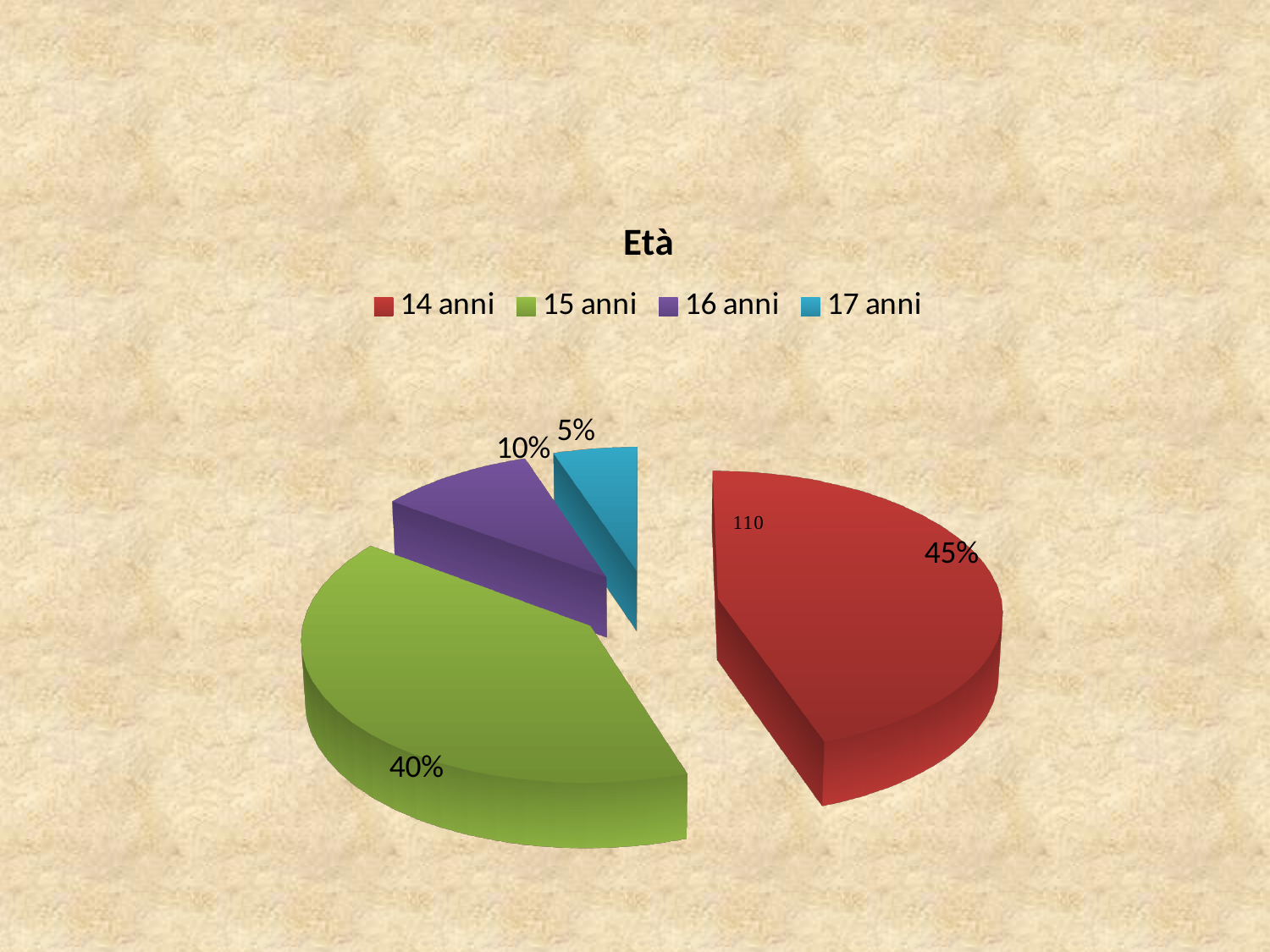
How many categories does the legend list? 4 What percentage of the pie is the 16 anni slice? 10% What is the title of the chart? Età What is the difference in percentage points between the 14 anni and 15 anni slices? 5% What kind of chart is shown on the slide? pie chart What colour is the 15 anni slice? green What percentage of the pie is the 14 anni slice? 45% Which age group has the largest share of the pie? 14 anni What percentage of the pie is the 17 anni slice? 5% Which age group has the smallest share of the pie? 17 anni Which slice is larger, 16 anni or 17 anni? 16 anni